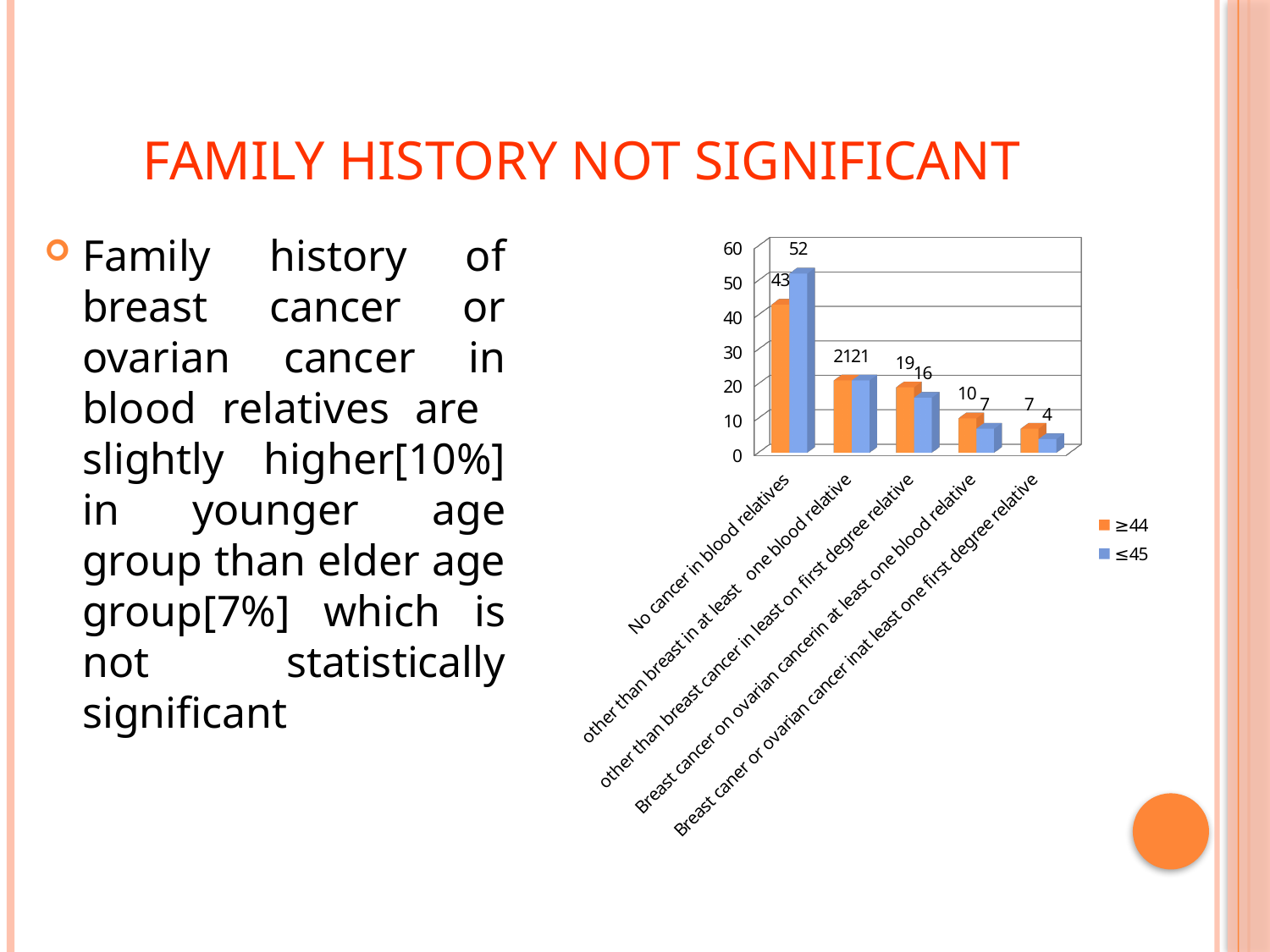
What is the value for ≥44 in the 'Breast cancer on ovarian cancer in at least one blood relative' category? 10 Which category has the lowest value for the ≤45 series? Breast caner or ovarian cancer in at least one first degree relative Which category has the highest value for the ≤45 series? No cancer in blood relatives What is the value for ≤45 in the 'No cancer in blood relatives' category? 52 What is the value for ≤45 in the 'other than breast cancer in least on first degree relative' category? 16 How many categories are shown on the x axis of the chart? 5 Is the ≥44 value for 'No cancer in blood relatives' greater or less than 40? greater What type of chart is shown on the slide? Bar chart In the 'Breast caner or ovarian cancer in at least one first degree relative' category, which series has the larger value, ≥44 or ≤45? ≥44 What is the difference between the ≤45 and ≥44 values in the 'No cancer in blood relatives' category? 9 How many series does the chart legend list? 2 What is the value for ≥44 in the 'No cancer in blood relatives' category? 43